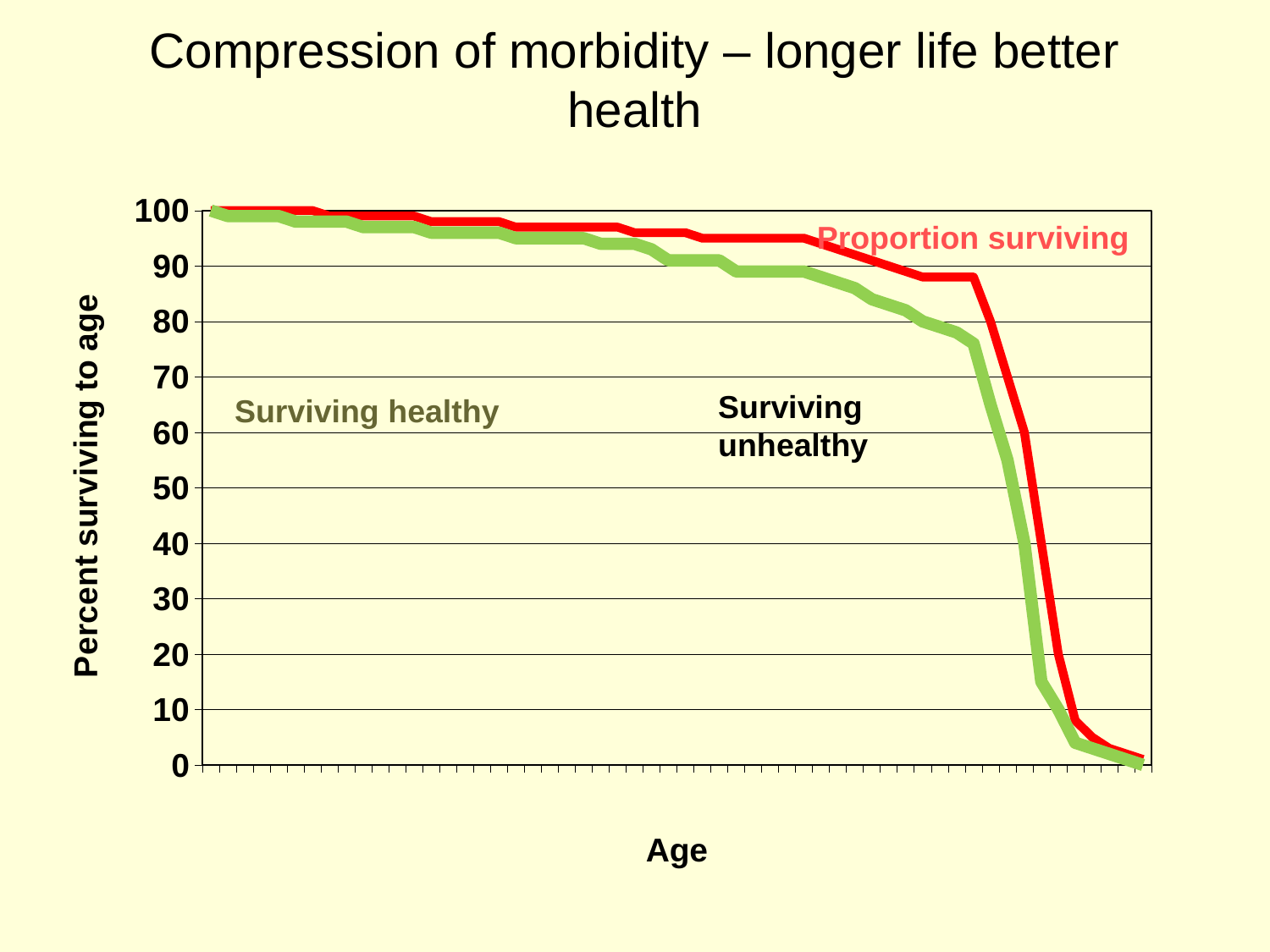
What is the label of the y axis? Percent surviving to age Do the values of the 'Surviving healthy' line rise or fall as age increases along the x axis? Fall What is the label of the x axis? Age Which line is higher across the chart, 'Proportion surviving' or 'Surviving healthy'? Proportion surviving What kind of chart is shown on the slide? Line chart How many lines (series) are plotted on the chart? 2 What is the highest value shown on the y axis? 100 Do the values of the 'Proportion surviving' line rise or fall as age increases along the x axis? Fall Which line reaches a lower value at the right-hand end of the chart, 'Proportion surviving' or 'Surviving healthy'? Surviving healthy What is the lowest value shown on the y axis? 0